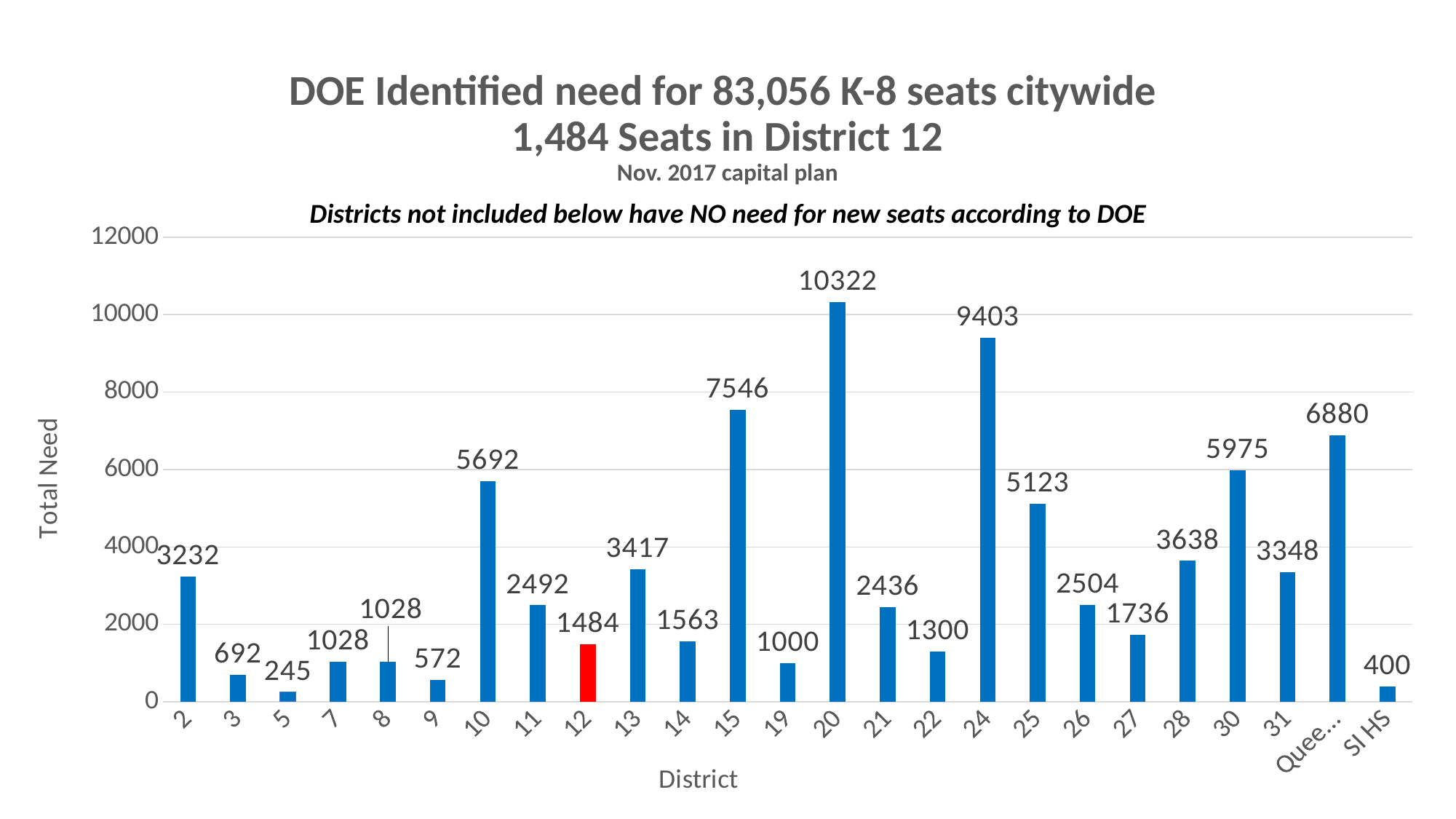
What type of chart is shown on the slide? bar chart Which district has the highest total need? 20 Which bar is highlighted in red? District 12 How many districts (bars) are shown in the chart? 25 What is the total need for District 12? 1484 What is the difference in total need between District 20 and District 24? 919 Which has a larger total need, District 30 or District 10? 30 What is the total need for District 15? 7546 Which district has the lowest total need? 5 What is the total need for District 20? 10322 What is the total need for SI HS? 400 Is the value for District 24 greater or less than 8000? greater